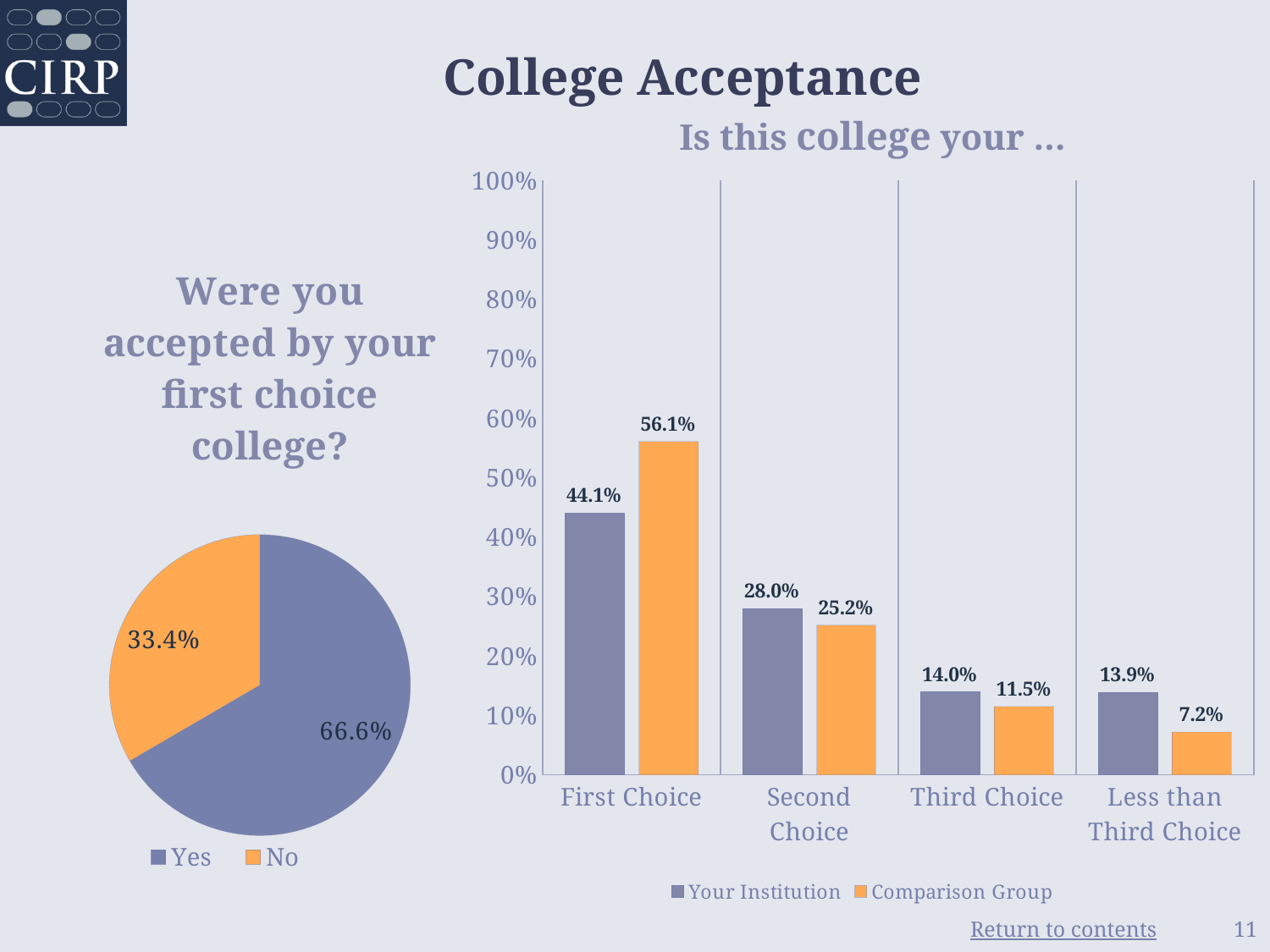
In the pie chart 'Were you accepted by your first choice college?', what percentage answered No? 33.4% In the bar chart 'Is this college your ...', what is the difference between Comparison Group and Your Institution for First Choice? 12.0% In the pie chart 'Were you accepted by your first choice college?', which slice is larger, Yes or No? Yes In the bar chart 'Is this college your ...', how many series does the legend list? 2 In the bar chart 'Is this college your ...', which category has the highest value for Comparison Group? First Choice What kind of chart is the chart on the left of the slide? Pie chart In the bar chart 'Is this college your ...', what is the value for Your Institution for First Choice? 44.1% In the pie chart 'Were you accepted by your first choice college?', what percentage answered Yes? 66.6% What kind of chart is the chart titled 'Is this college your ...'? Bar chart In the bar chart 'Is this college your ...', how many categories are shown on the x axis? 4 In the bar chart 'Is this college your ...', which is larger for Second Choice, Your Institution or Comparison Group? Your Institution In the bar chart 'Is this college your ...', what is the value for Comparison Group for Less than Third Choice? 7.2%